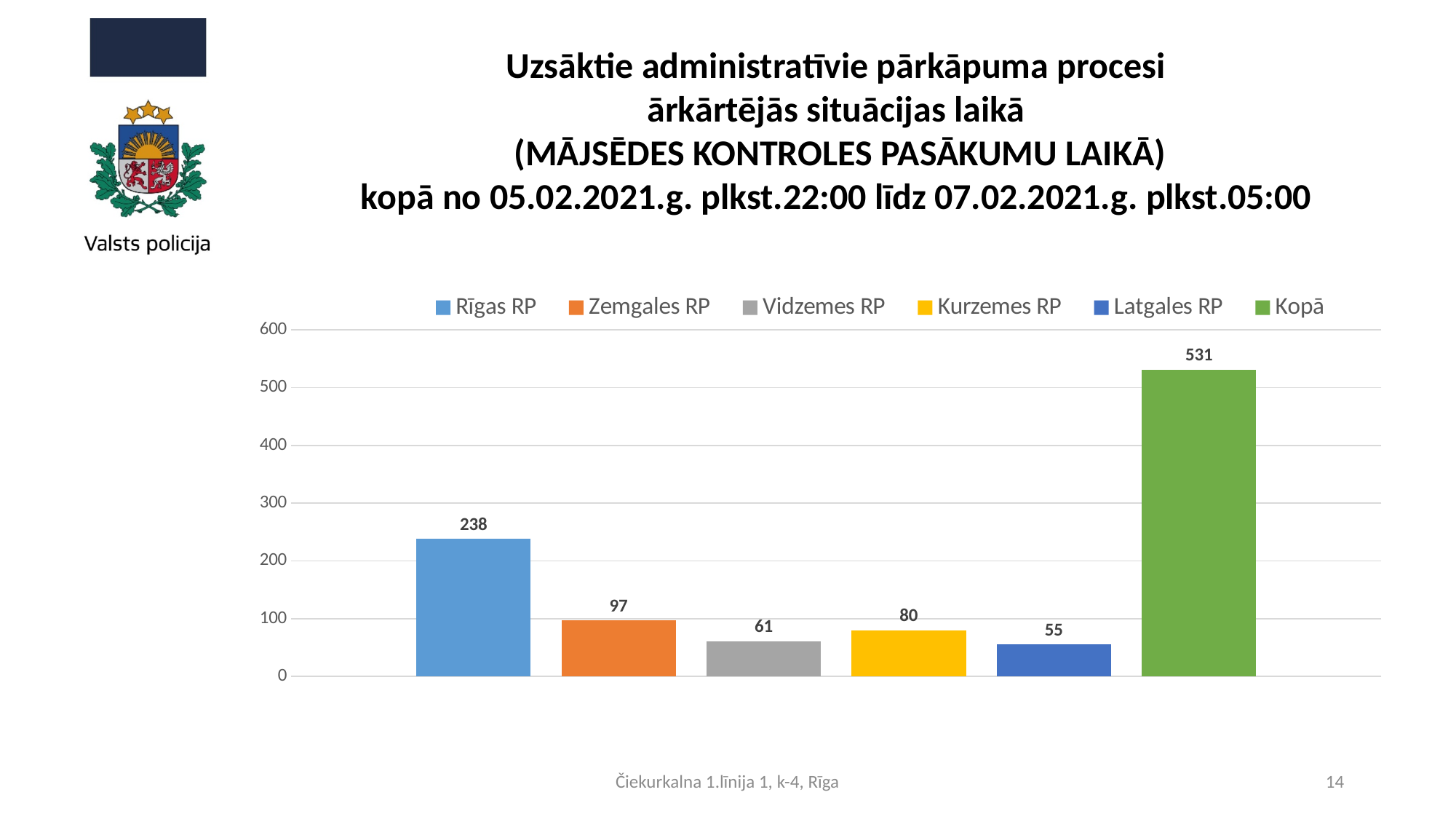
Which is larger, the value for Kurzemes RP or Vidzemes RP? Kurzemes RP What is the value for Rīgas RP? 238 What kind of chart is shown on the slide? bar chart What is the value for Kopā? 531 Which regional police (RP) has the highest value, excluding Kopā? Rīgas RP What colour is the Kopā bar? green What is the value for Latgales RP? 55 What is the value for Zemgales RP? 97 What is the difference between the values for Rīgas RP and Zemgales RP? 141 Which bar has the lowest value? Latgales RP Is the value for Vidzemes RP greater or less than 100? less How many series does the legend list? 6